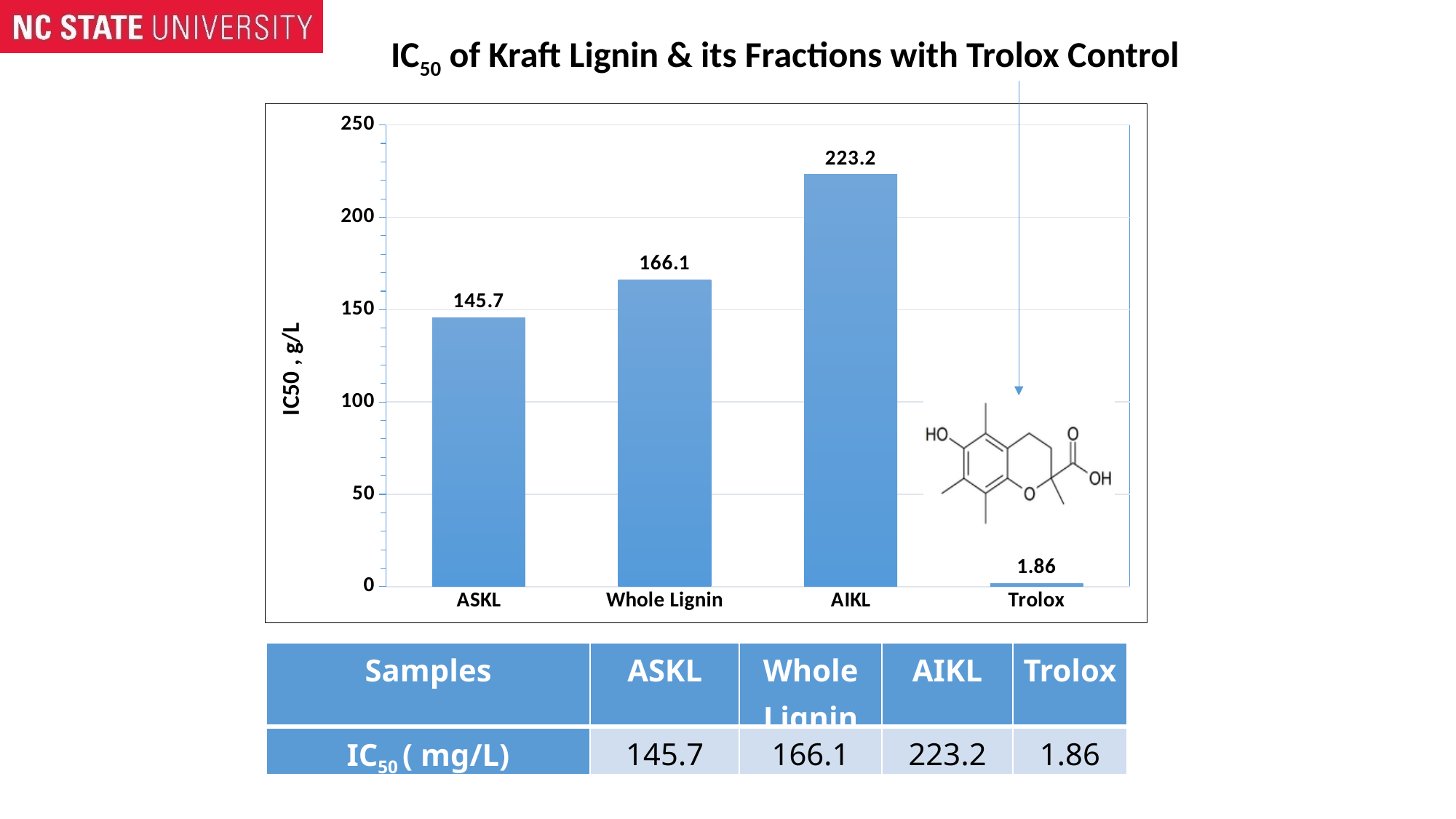
How many samples are shown in the chart? 4 Which has a larger IC50 value, Whole Lignin or ASKL? Whole Lignin What is the difference between the IC50 values of Whole Lignin and ASKL? 20.4 Is the IC50 value for AIKL greater or less than 200? greater What is the IC50 value for AIKL? 223.2 Which sample has the highest IC50 value? AIKL What is the IC50 value for Trolox? 1.86 What is the IC50 value for ASKL? 145.7 What is the IC50 value for Whole Lignin? 166.1 Which sample has the lowest IC50 value? Trolox What is the difference between the IC50 values of AIKL and ASKL? 77.5 What kind of chart is shown on the slide? Bar chart